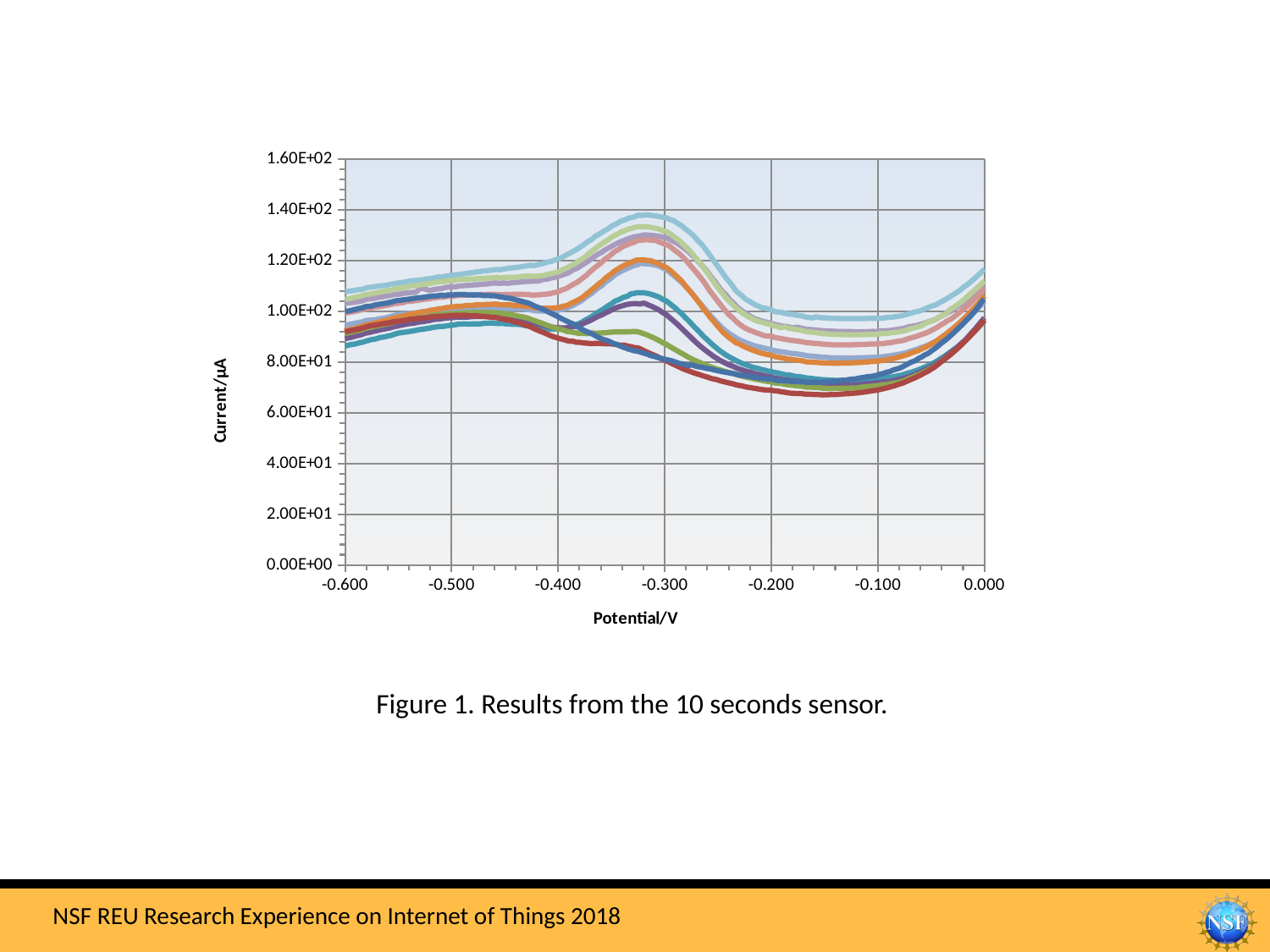
What is the title of the y axis of the chart? Current/μA What is the highest value labelled on the y axis? 1.60E+02 What is the rightmost value labelled on the x axis? 0.000 What kind of chart is shown on the slide? line chart Is the current of the top curve at -0.600 V greater or less than 1.00E+02? greater What is the leftmost value labelled on the x axis? -0.600 How many tick labels are shown along the x axis? 7 Do the curves rise or fall as the potential goes from -0.100 V to 0.000 V? rise What is the title of the x axis of the chart? Potential/V Is the peak current of the highest curve near -0.300 V greater or less than 1.20E+02? greater Do the curves rise or fall as the potential goes from -0.300 V to -0.150 V? fall Is the lowest current reached by the bottom curve near -0.150 V greater or less than 8.00E+01? less